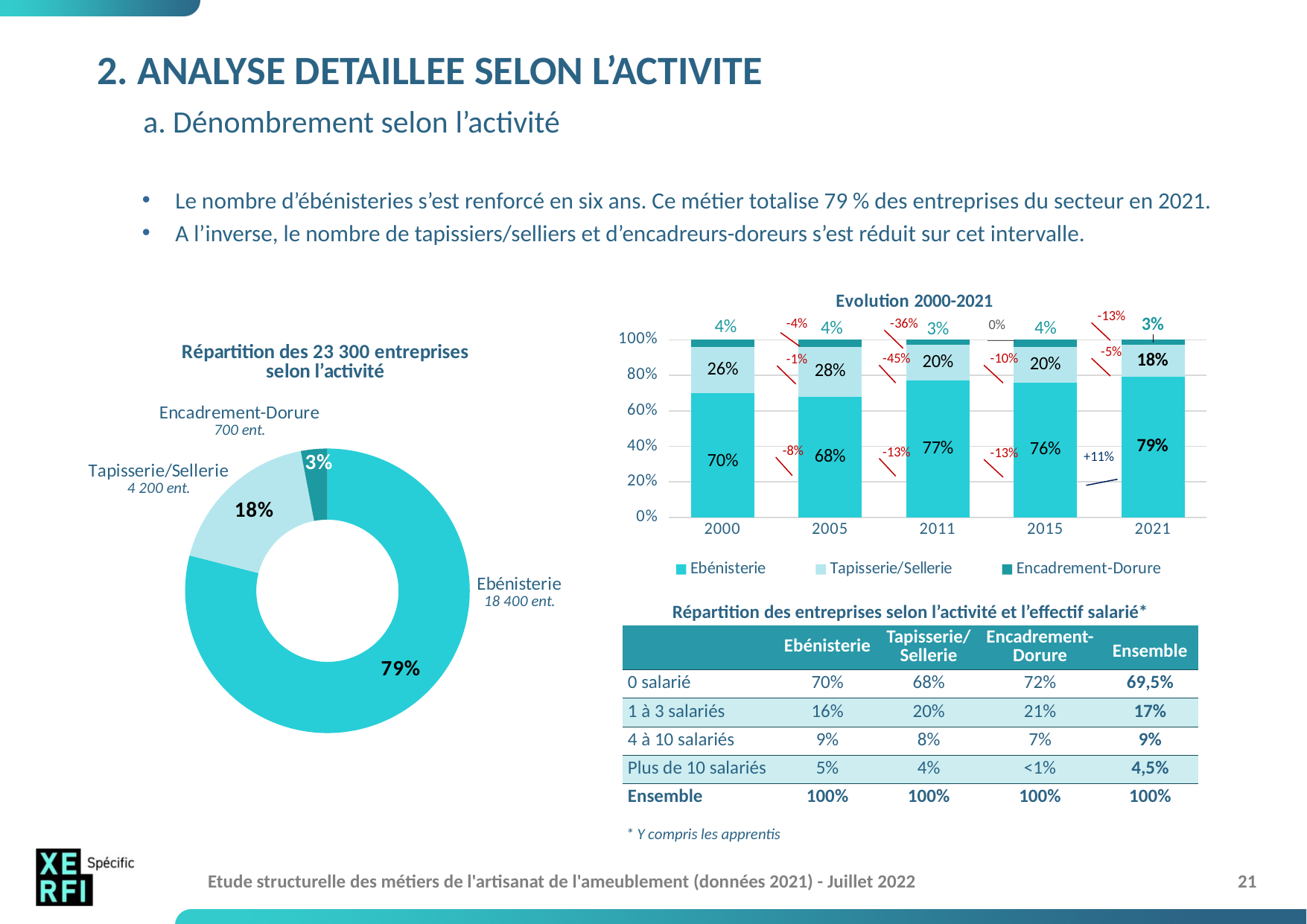
In the 'Evolution 2000-2021' chart, what is the value for Tapisserie/Sellerie in 2000? 26% In the 'Evolution 2000-2021' chart, what is the value for Ebénisterie in 2005? 68% In the 'Evolution 2000-2021' chart, does the Tapisserie/Sellerie share rise or fall from 2005 to 2021? Fall In the donut chart 'Répartition des 23 300 entreprises selon l'activité', how many enterprises are in Tapisserie/Sellerie? 4 200 ent. In the donut chart 'Répartition des 23 300 entreprises selon l'activité', what share of enterprises is Ebénisterie? 79% How many series does the legend of the 'Evolution 2000-2021' chart list? 3 What kind of chart is 'Répartition des 23 300 entreprises selon l'activité'? Pie chart (donut) In the 'Evolution 2000-2021' chart, what is the difference between the Ebénisterie share in 2021 and in 2000? 9 percentage points How many years are shown on the x axis of the 'Evolution 2000-2021' chart? 5 In the 'Evolution 2000-2021' chart, which is larger: the Tapisserie/Sellerie share in 2005 or in 2011? 2005 In the 'Evolution 2000-2021' chart, in which year is the Ebénisterie share highest? 2021 In the donut chart 'Répartition des 23 300 entreprises selon l'activité', which activity has the smallest share? Encadrement-Dorure